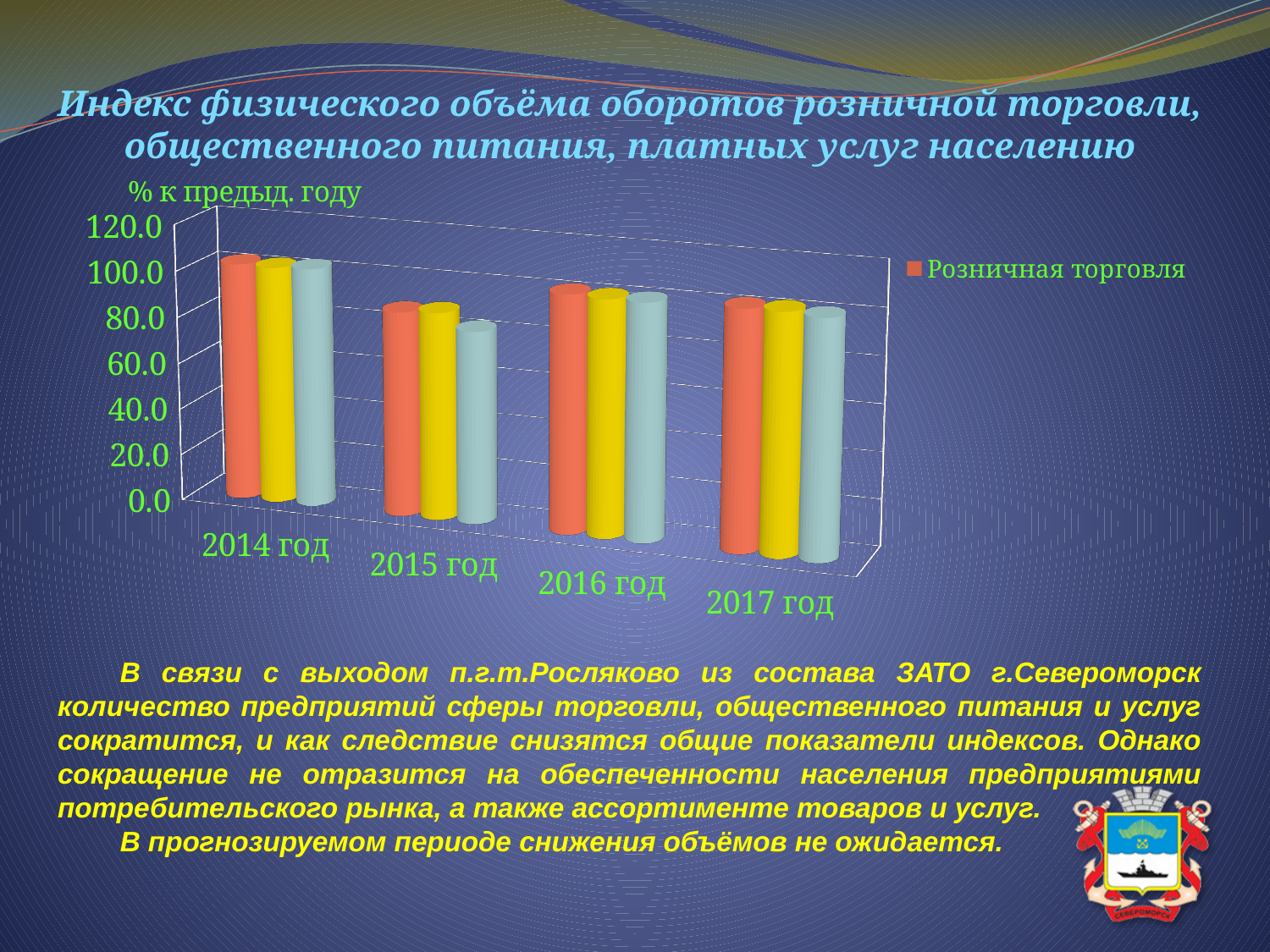
Which series is listed in the chart's legend? Розничная торговля What is the label of the vertical axis of the chart? % к предыд. году Is the value for Розничная торговля in 2014 год greater or less than 80? greater What kind of chart is shown on the slide? bar chart Is the value for Розничная торговля in 2015 год greater or less than 100? less Which is larger for Розничная торговля: the value in 2014 год or in 2015 год? 2014 год Is the value for Розничная торговля in 2016 год greater or less than 60? greater How many year categories are shown on the x axis of the chart? 4 Which is larger for Розничная торговля: the value in 2016 год or in 2015 год? 2016 год Does the value for Розничная торговля rise or fall from 2014 год to 2015 год? fall